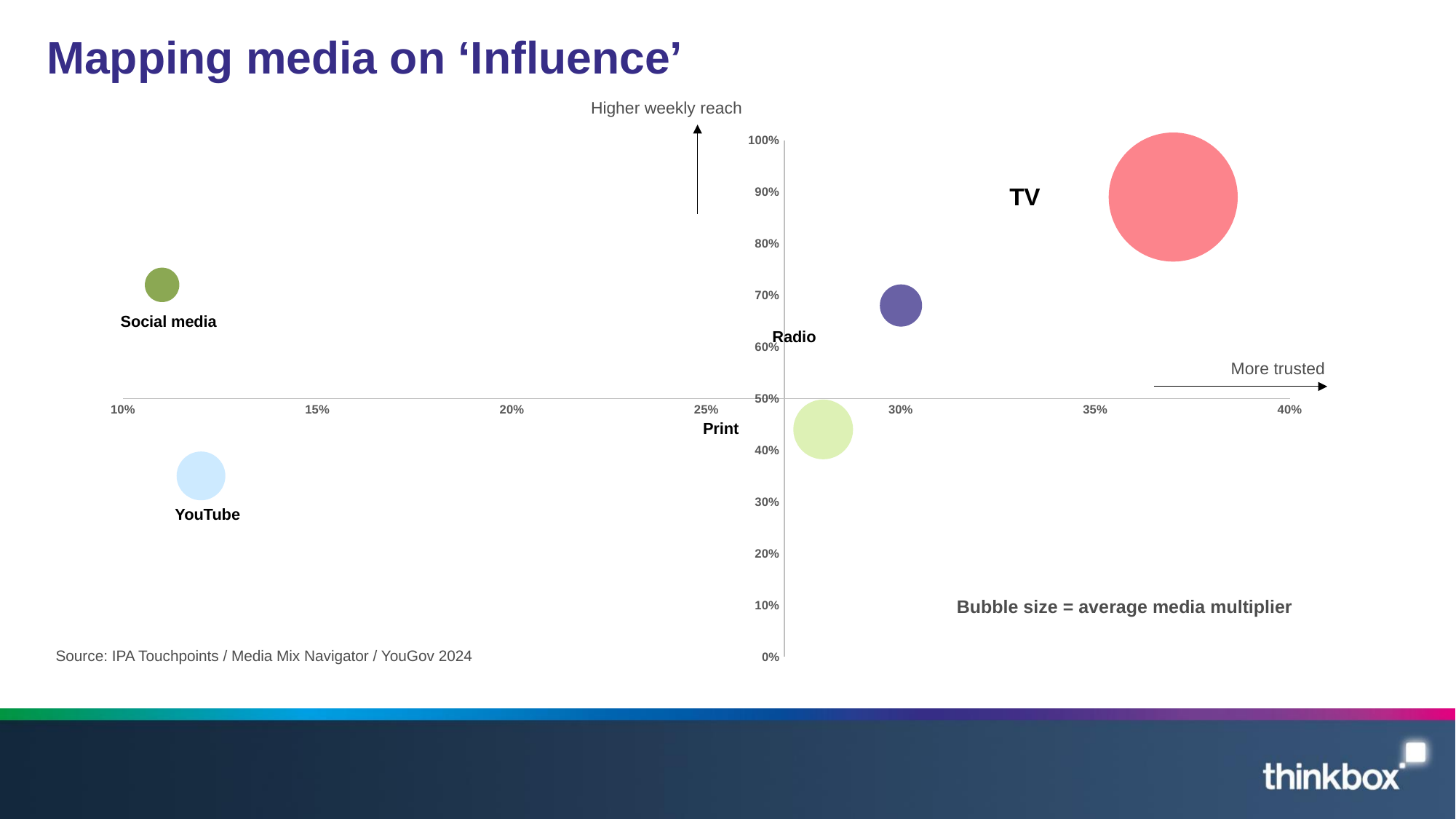
Is the weekly reach value for Print greater or less than 50%? less Which medium is positioned as the least trusted on the chart? Social media How many media bubbles are plotted on the chart? 5 Which has the higher weekly reach, Radio or Print? Radio Which medium is positioned as the most trusted on the chart? TV Which medium has the largest bubble on the chart? TV Which medium has the highest weekly reach on the chart? TV According to the note on the chart, what does bubble size represent? Average media multiplier Which medium has the lowest weekly reach on the chart? YouTube What kind of chart is shown on the slide? Bubble chart Is the weekly reach value for TV greater or less than 80%? greater Is the trust value for Social media greater or less than 15%? less